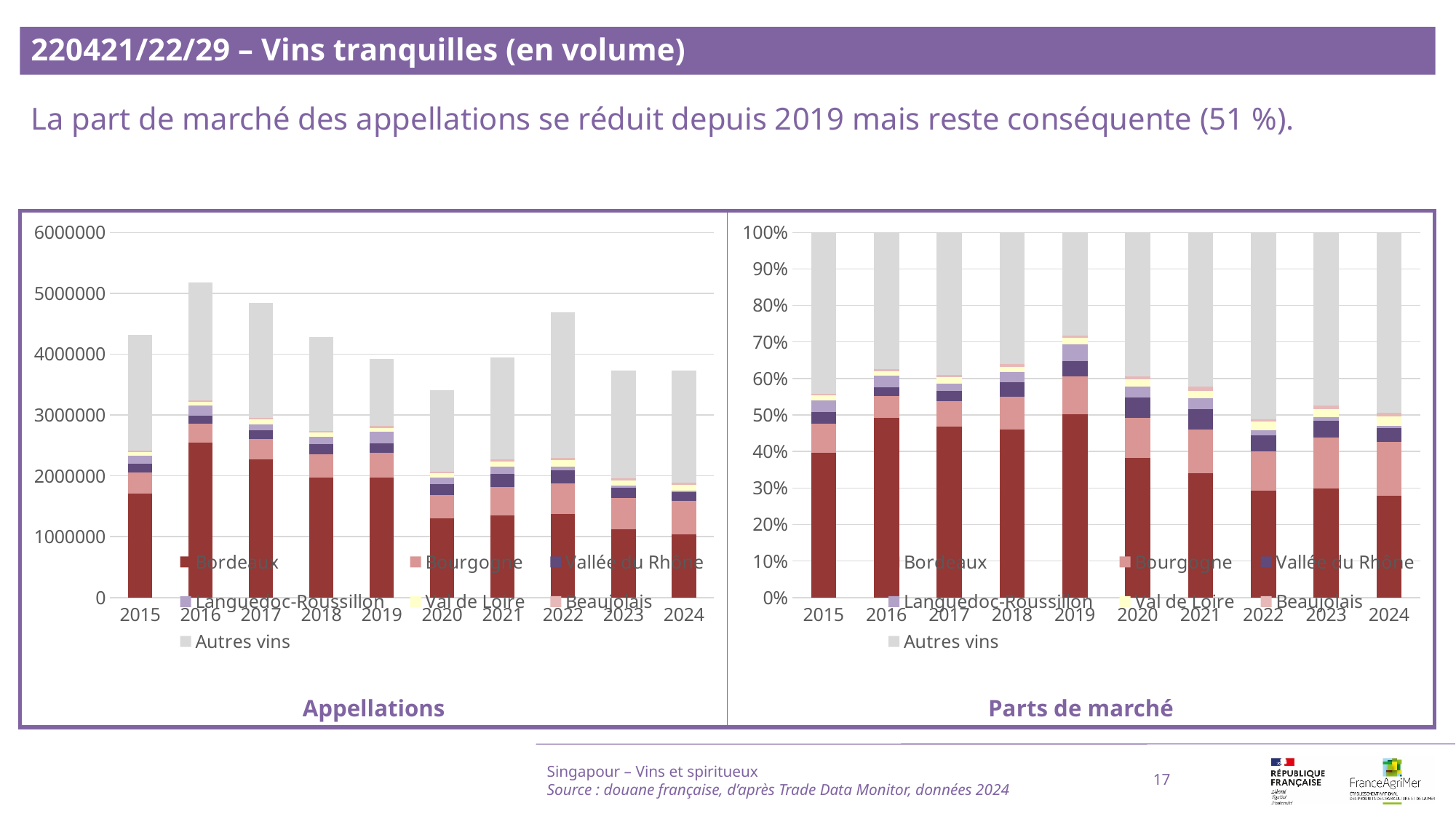
In the 'Appellations' chart, is the total bar for 2016 greater or less than 5000000? greater In the 'Parts de marché' chart, is the Bordeaux share in 2021 greater or less than 30%? greater How many years are shown on the x axis of the 'Parts de marché' chart? 10 How many series does the legend of the 'Appellations' chart list? 7 In the 'Appellations' chart, which year has the lowest total bar? 2020 Which series in the legend of the 'Parts de marché' chart is shown in grey? Autres vins In the 'Parts de marché' chart, is the Bordeaux share in 2024 greater or less than 30%? less In the 'Parts de marché' chart, does the Bordeaux share rise or fall from 2019 to 2024? Fall In the 'Appellations' chart, is the Bordeaux segment larger in 2016 or in 2024? 2016 What kind of chart is the 'Appellations' chart on the left? Stacked bar chart In the 'Appellations' chart, which year has the highest total bar? 2016